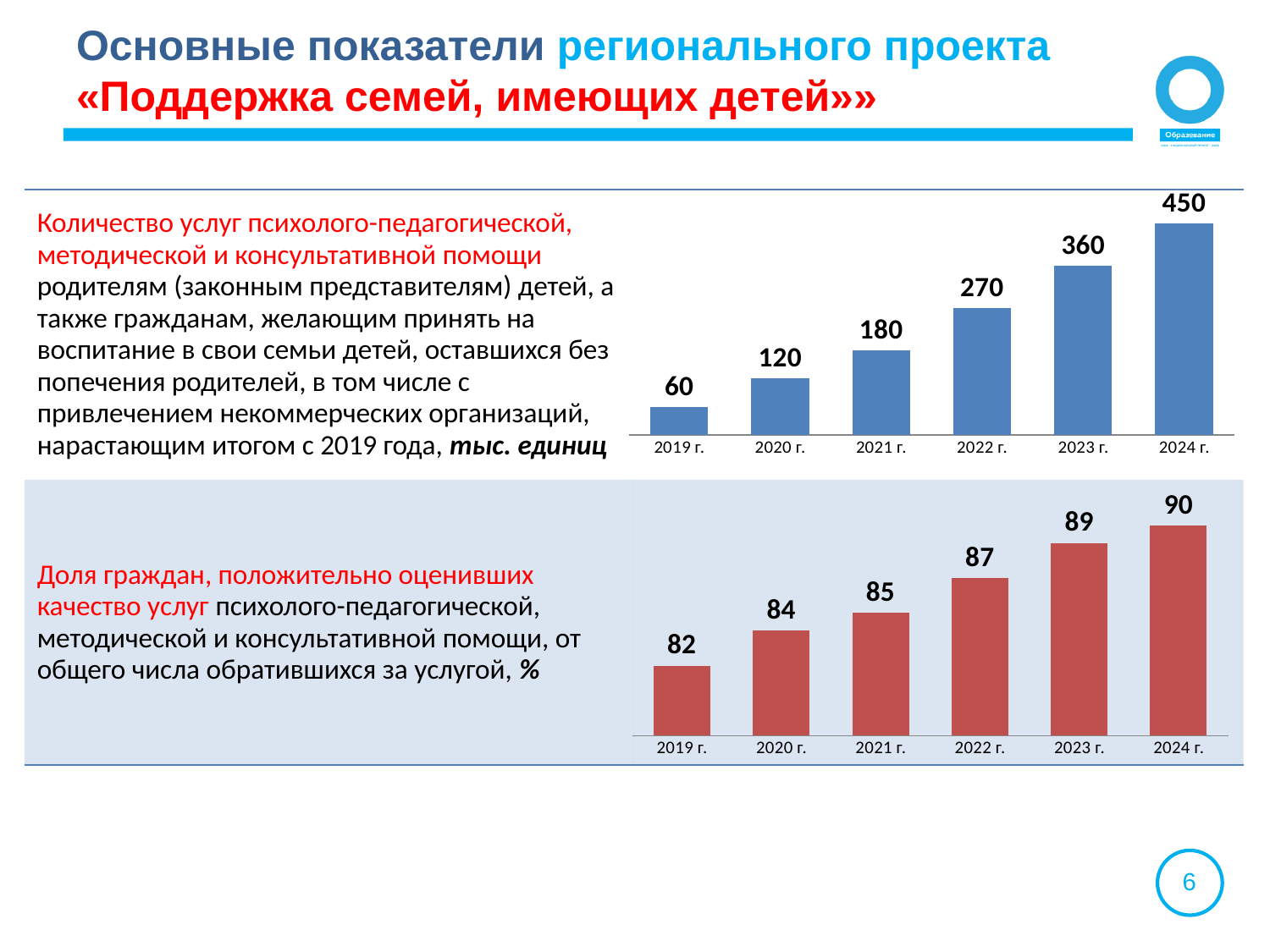
In the bottom chart (share of citizens who rated service quality positively, %), which year has the lowest value? 2019 г. In the top chart (number of services, thousand units), what is the value for 2022 г.? 270 In the top chart (number of services, thousand units), what is the difference between the values for 2024 г. and 2023 г.? 90 In the top chart (number of services, thousand units), do the values rise or fall from 2019 г. to 2024 г.? rise What kind of chart is the bottom chart (share of citizens who rated service quality positively, %)? bar chart In the bottom chart (share of citizens who rated service quality positively, %), what is the difference between the values for 2024 г. and 2019 г.? 8 In the bottom chart (share of citizens who rated service quality positively, %), which is larger, the value for 2022 г. or 2020 г.? 2022 г. In the top chart (number of services, thousand units), what is the value for 2019 г.? 60 What colour are the bars in the top chart (number of services, thousand units)? blue In the top chart (number of services, thousand units), which year has the highest value? 2024 г. In the top chart (number of services, thousand units), how many years are shown? 6 In the bottom chart (share of citizens who rated service quality positively, %), what is the value for 2021 г.? 85